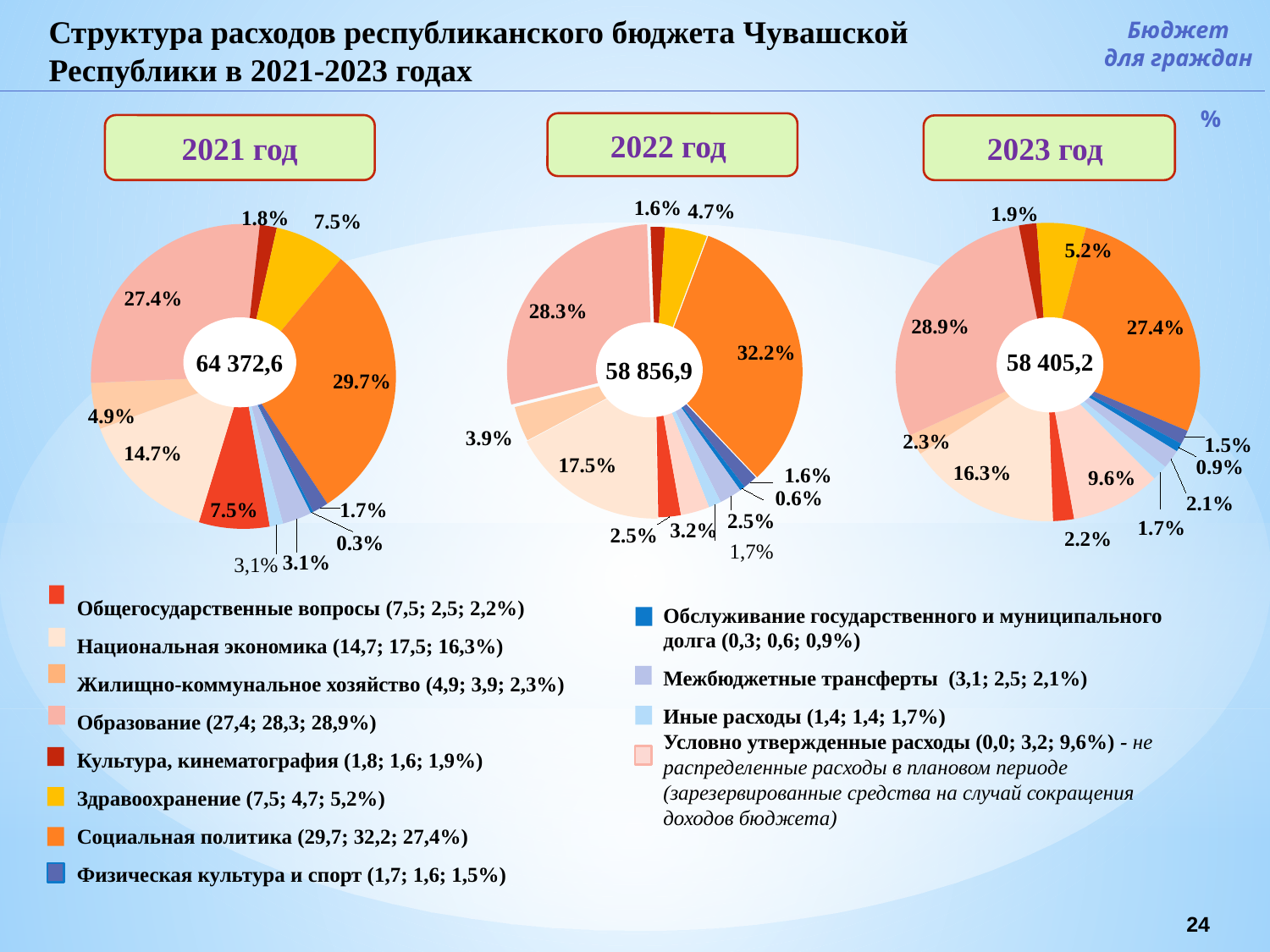
In the 2023 год pie chart, which is larger: Образование or Социальная политика? Образование In the 2023 год pie chart, what share is shown for Образование? 28.9% What total value is printed in the centre of the 2021 год pie chart? 64 372,6 In the 2021 год pie chart, which category has the smallest slice? Обслуживание государственного и муниципального долга (0.3%) How many pie charts are shown on the slide? 3 In the 2022 год pie chart, which category has the largest slice? Социальная политика (32.2%) What total value is printed in the centre of the 2023 год pie chart? 58 405,2 What type of chart is used on this slide? Pie chart In the 2021 год pie chart, what share is shown for Социальная политика? 29.7% According to the legend, does the share of Условно утвержденные расходы rise or fall from 2021 to 2023? Rise In the 2022 год pie chart, what is the difference between the shares of Образование and Национальная экономика? 10.8 percentage points In the 2022 год pie chart, what share is shown for Здравоохранение? 4.7%